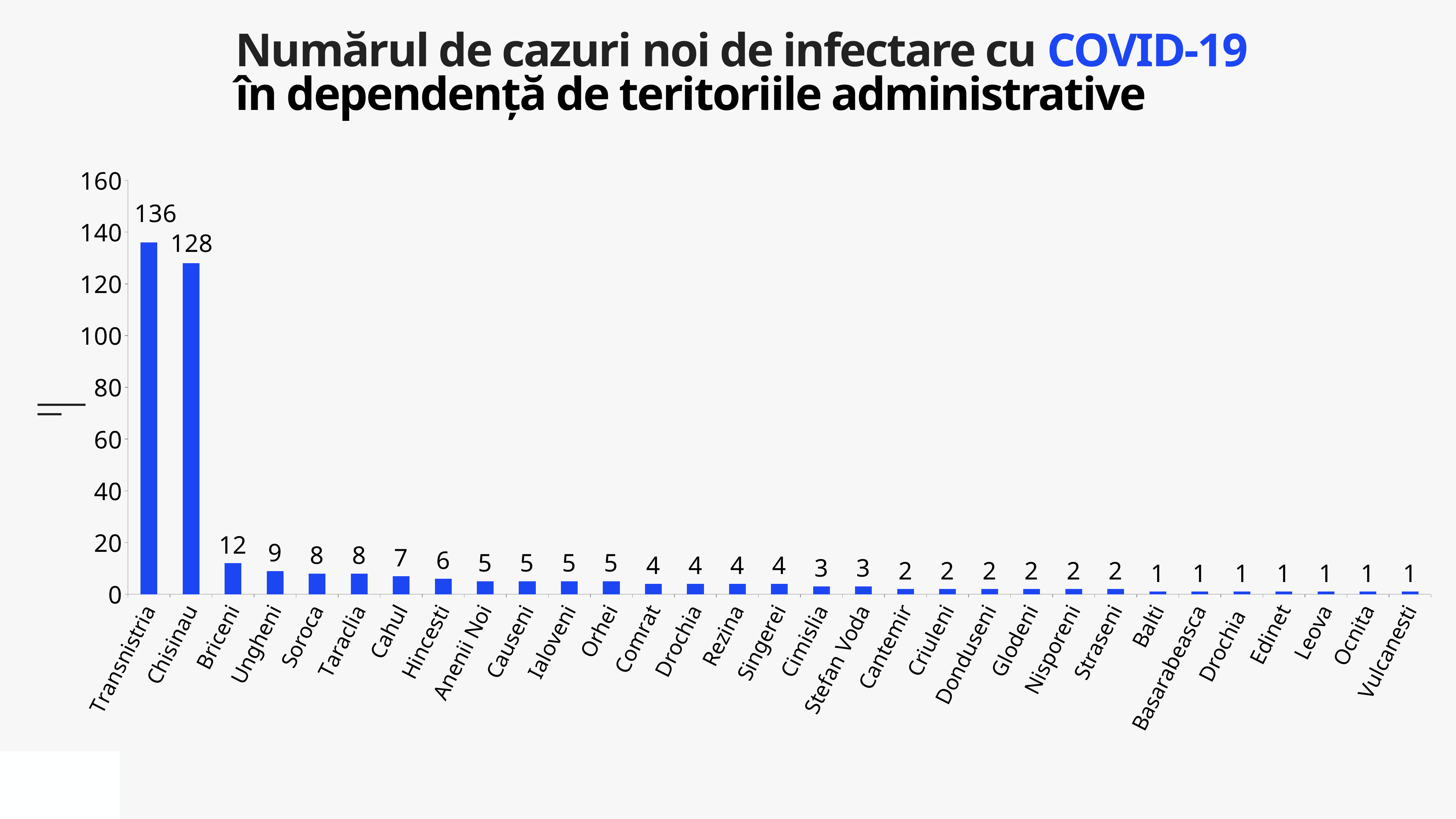
What is the difference between the values for Transnistria and Chisinau? 8 Do the values rise or fall from left to right along the x axis? Fall What is the number of new COVID-19 cases for Chisinau? 128 How many territories (bars) are shown on the chart? 31 What is the value shown for Briceni? 12 What is the value shown for Cahul? 7 What kind of chart is shown on the slide? Bar chart Which has a larger value, Soroca or Hincesti? Soroca What is the difference between the values for Briceni and Ungheni? 3 Which territory has the highest number of new cases? Transnistria What is the value shown for Stefan Voda? 3 What is the number of new COVID-19 cases for Transnistria? 136